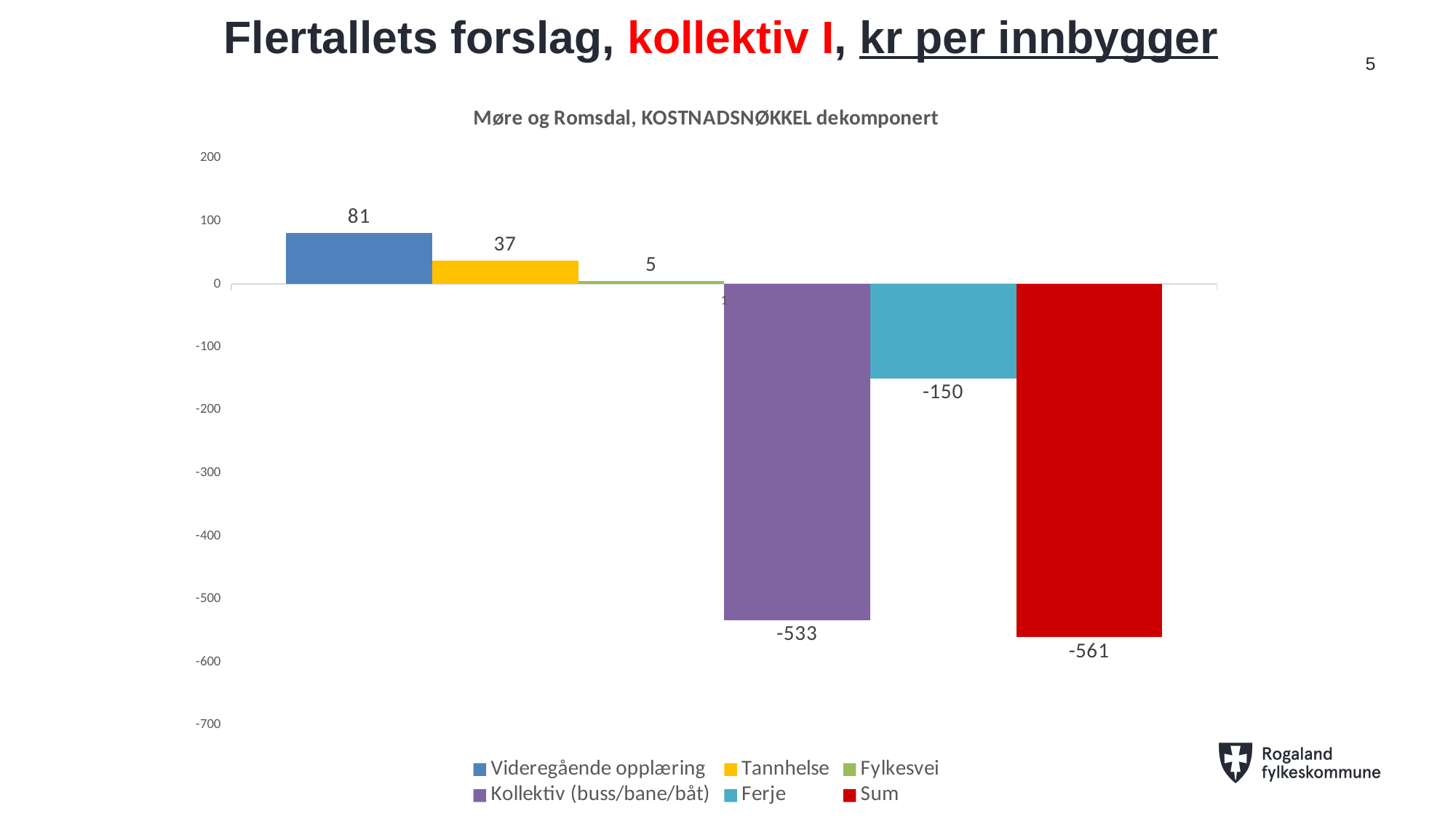
What is the title of the chart? Møre og Romsdal, KOSTNADSNØKKEL dekomponert What is the value for Tannhelse? 37 Which series has the lowest value? Sum What is the value for Kollektiv (buss/bane/båt)? -533 What kind of chart is shown? Bar chart How many series does the legend list? 6 Which series has the highest value? Videregående opplæring What is the value for Ferje? -150 What is the difference between the values for Videregående opplæring and Tannhelse? 44 What is the value for Videregående opplæring? 81 What is the value for Sum? -561 Which is larger, the value for Tannhelse or the value for Fylkesvei? Tannhelse